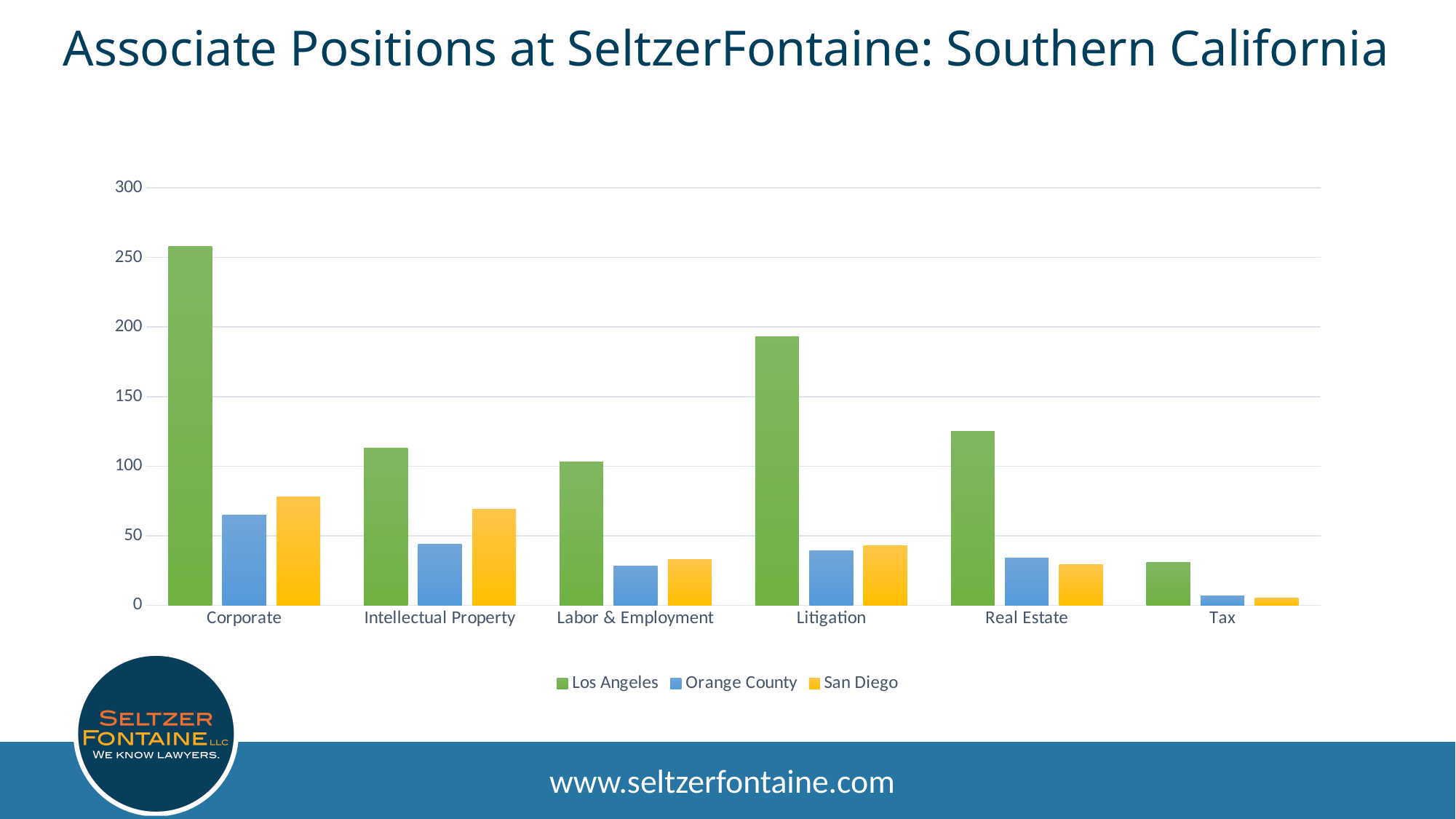
Which practice area has the lowest Los Angeles value? Tax How many series does the legend list? 3 For Corporate, which is larger: the Orange County value or the San Diego value? San Diego Which practice area has the highest San Diego value? Corporate How many practice-area categories are shown on the x axis? 6 For Intellectual Property, which is larger: the Orange County value or the San Diego value? San Diego Is the Los Angeles value for Corporate greater or less than 250? greater Is the Los Angeles value for Litigation greater or less than 200? less What kind of chart is shown on the slide? bar chart Is the Los Angeles value for Intellectual Property greater or less than 100? greater Which practice area has the highest Los Angeles value? Corporate What colour represents Los Angeles in the legend? green